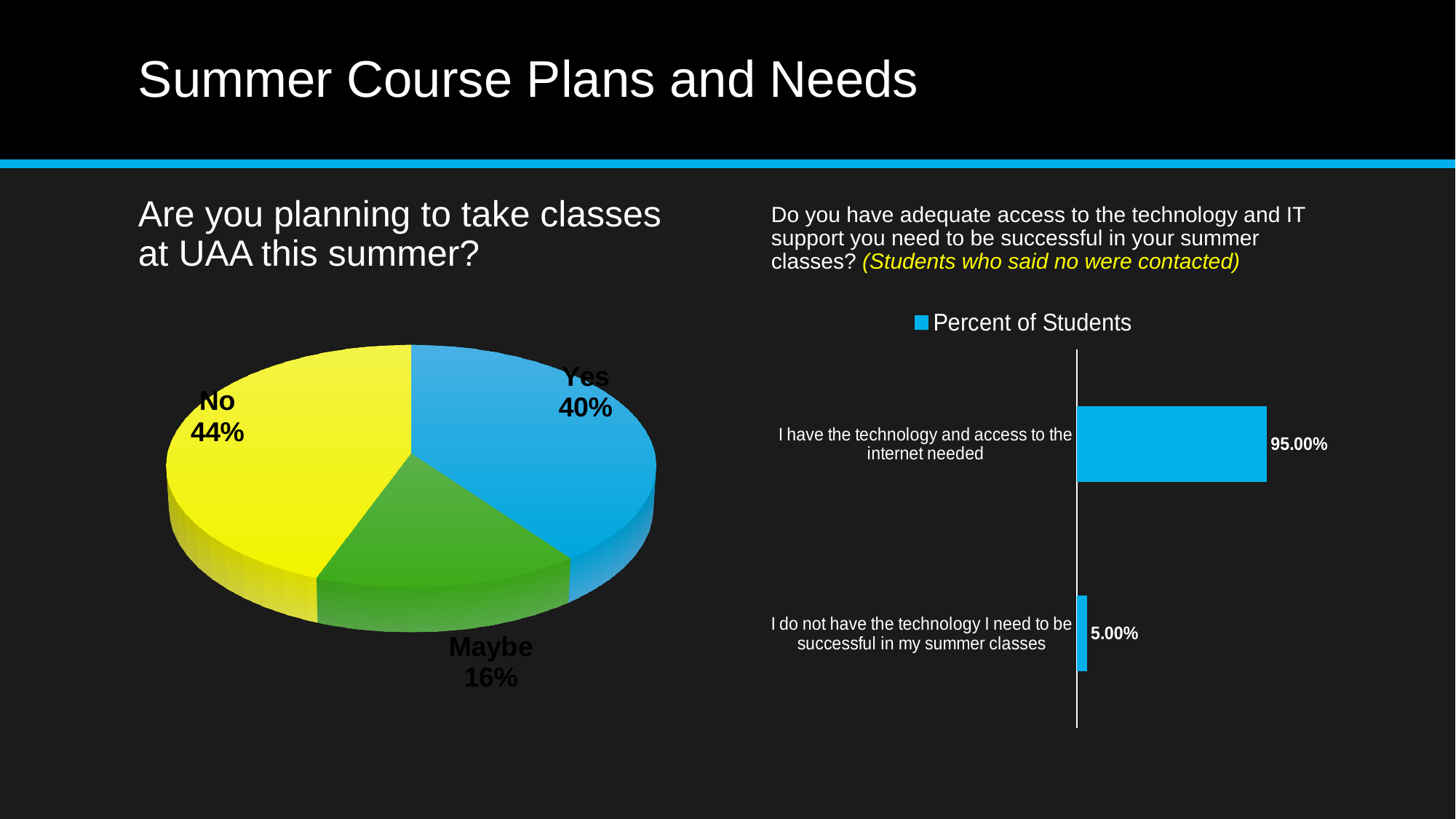
In the bar chart on the right, what is the value for "I do not have the technology I need to be successful in my summer classes"? 5.00% What type of chart is shown on the right side of the slide? Bar chart In the pie chart on the left, which response has the largest share? No In the bar chart on the right, what is the value for "I have the technology and access to the internet needed"? 95.00% In the pie chart on the left, how many slices are there? 3 In the pie chart on the left, which response has the smallest share? Maybe In the pie chart on the left, how many percentage points larger is "No" than "Yes"? 4 What type of chart is shown on the left side of the slide? Pie chart In the pie chart on the left, what percentage of students answered "Maybe"? 16% In the bar chart on the right, what series name does the legend show? Percent of Students In the bar chart on the right, what is the difference between the two bars? 90.00% In the pie chart on the left, what percentage of students answered "No"? 44%